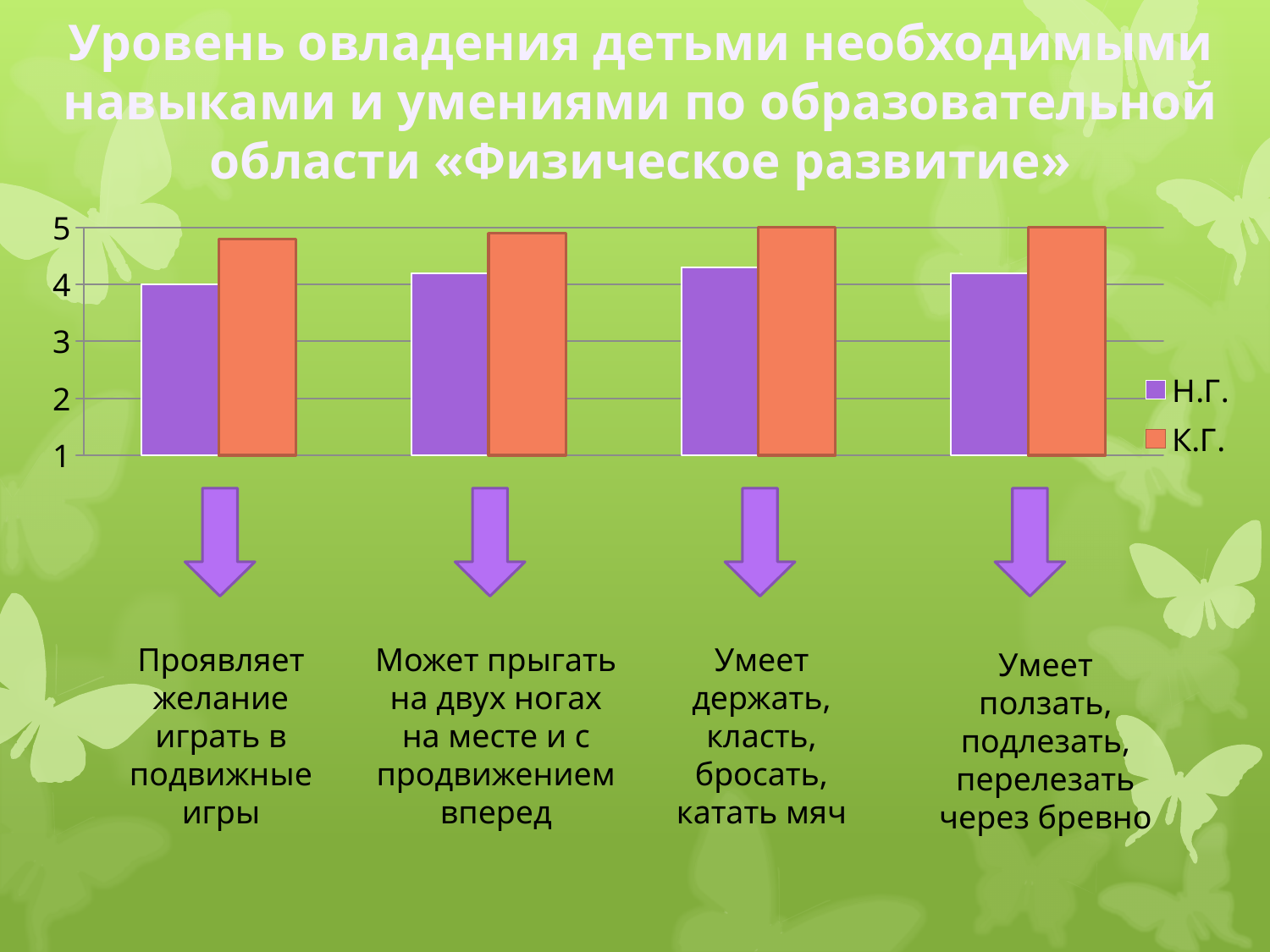
What kind of chart is shown on the slide? bar chart How many categories (groups of bars) are plotted in the chart? 4 What is the Н.Г. value for «Проявляет желание играть в подвижные игры»? 4 Is the К.Г. value for «Умеет держать, класть, бросать, катать мяч» greater or less than 4? greater What are the two entries in the chart legend? Н.Г. and К.Г. In every category, which series is higher, Н.Г. or К.Г.? К.Г. How many series does the legend list? 2 What colour are the К.Г. bars? orange Is the Н.Г. value for «Умеет ползать, подлезать, перелезать через бревно» greater or less than 5? less Is the Н.Г. value for «Проявляет желание играть в подвижные игры» greater or less than 3? greater For the category «Проявляет желание играть в подвижные игры», which series has the larger value, Н.Г. or К.Г.? К.Г. Which category has the lowest Н.Г. value? Проявляет желание играть в подвижные игры